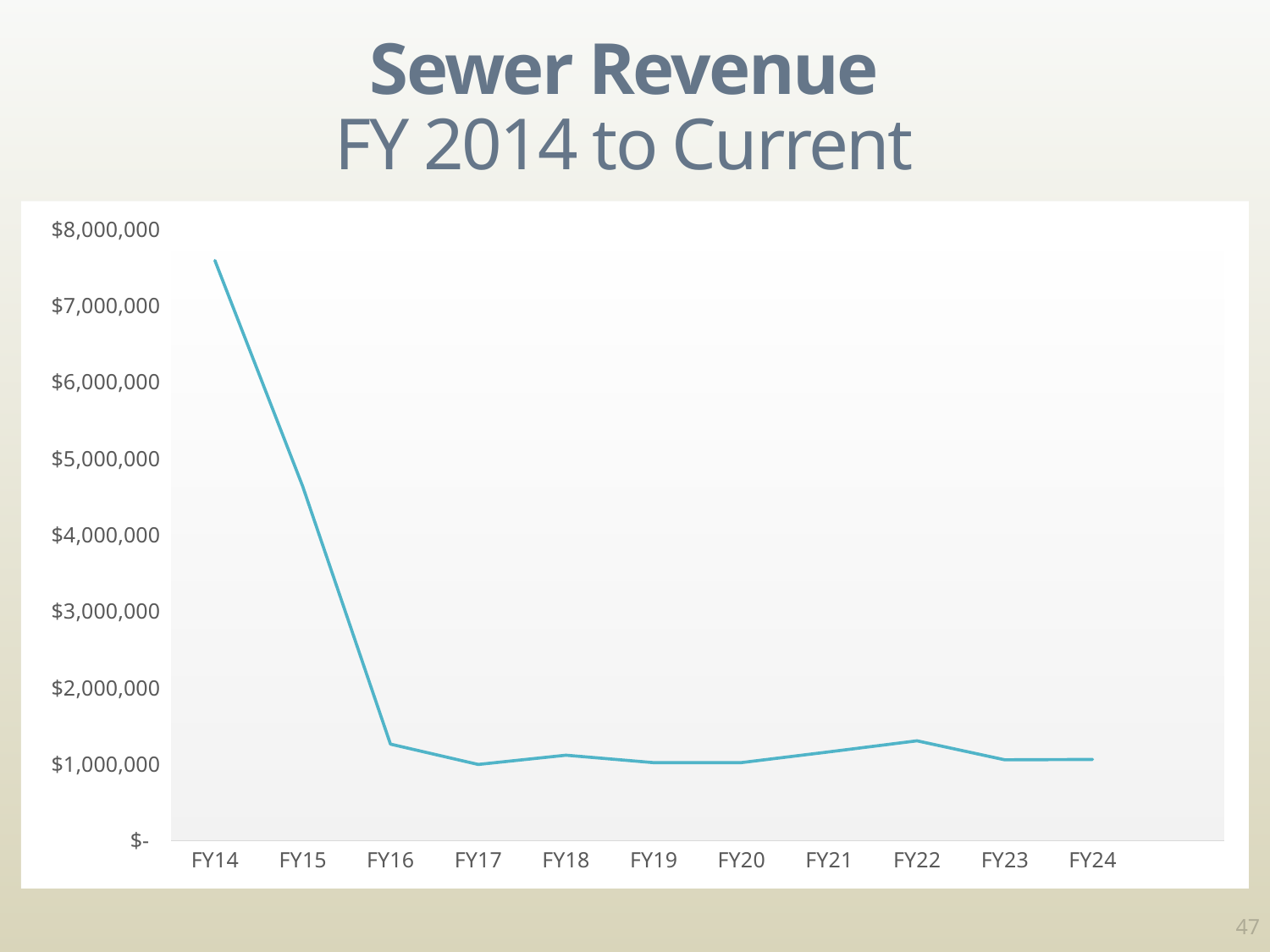
What is the title of the chart on the slide? Sewer Revenue FY 2014 to Current Which is larger, the value for FY14 or the value for FY15? FY14 Is the value for FY16 greater or less than $1,000,000? greater Which is larger, the value for FY16 or the value for FY17? FY16 Do the values rise or fall from FY14 to FY16? fall How many fiscal years are plotted on the x axis? 11 What kind of chart is shown on the slide? Line chart Which is larger, the value for FY22 or the value for FY23? FY22 Is the value for FY15 greater or less than $5,000,000? less Which fiscal year has the highest sewer revenue? FY14 Is the value for FY22 greater or less than $2,000,000? less